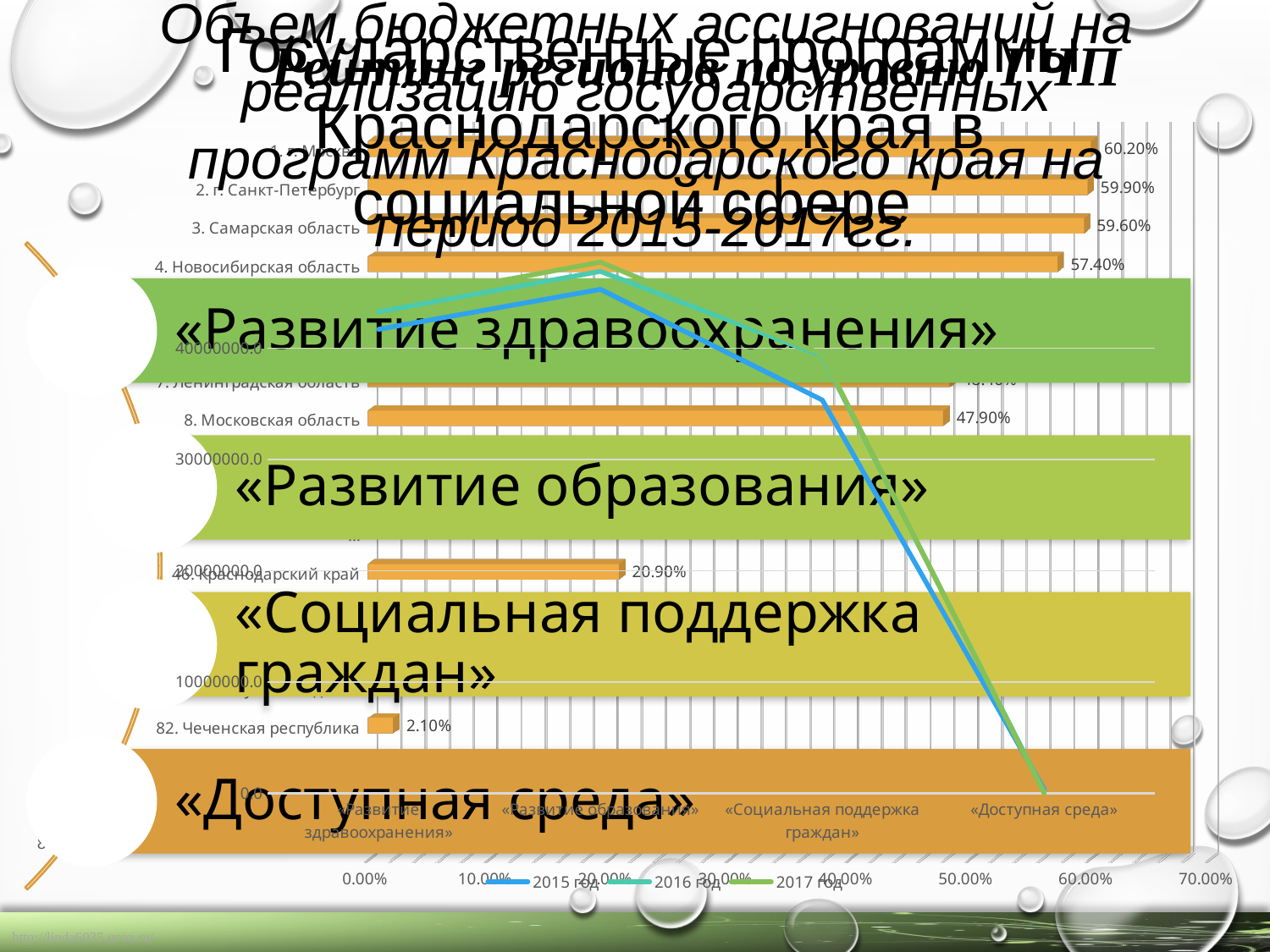
In the horizontal bar chart, what is the value for 46. Краснодарский край? 20.90% In the line chart, do the values rise or fall from «Развитие образования» to «Доступная среда»? fall In the horizontal bar chart, what is the value for 1. г. Москва? 60.20% In the line chart, how many categories are shown on the x axis? 4 In the horizontal bar chart, which region has the highest value? 1. г. Москва What kind of chart is the chart showing the rating of regions with percentage values? bar chart In the horizontal bar chart, what is the difference between the values for 1. г. Москва and 46. Краснодарский край? 39.30% In the horizontal bar chart, what is the value for 82. Чеченская республика? 2.10% In the horizontal bar chart, which is larger: the value for 3. Самарская область or for 8. Московская область? 3. Самарская область In the line chart, how many series does the legend list? 3 In the line chart, is the value of 2015 год for «Доступная среда» greater or less than 10000000.0? less